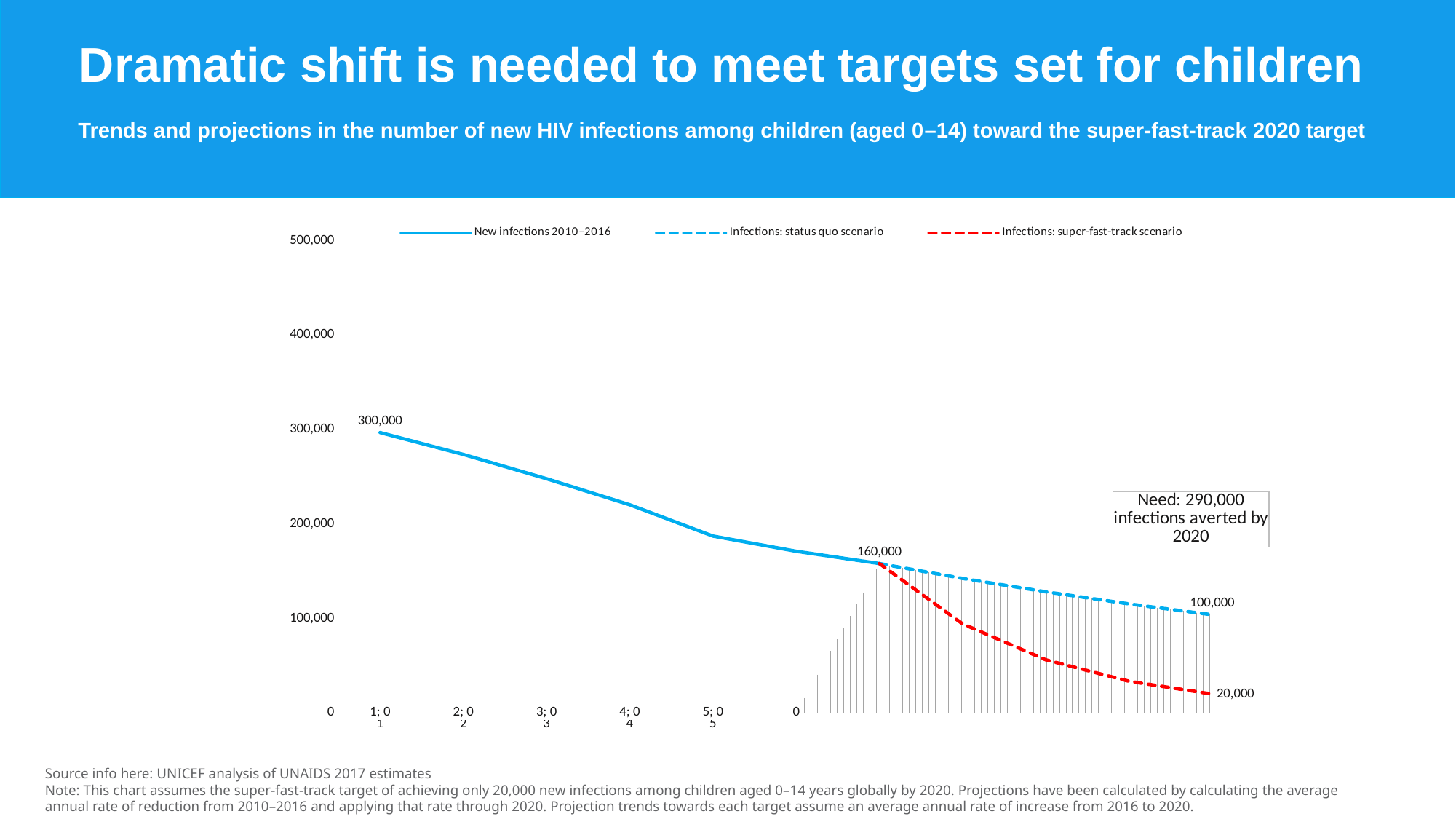
By how much does the 'New infections 2010–2016' line fall from its starting value of 300,000 to its ending value of 160,000? 140,000 What is the final value of the 'Infections: status quo scenario' line? 100,000 What is the final value of the 'Infections: super-fast-track scenario' line? 20,000 Does the 'New infections 2010–2016' line rise or fall from left to right? fall What is the value at the point where the solid 'New infections 2010–2016' line ends and the projection lines begin? 160,000 What is the difference between the final value of the status quo scenario (100,000) and the final value of the super-fast-track scenario (20,000)? 80,000 What is the value at the start of the 'New infections 2010–2016' line? 300,000 What kind of chart is shown on the slide? line chart How many series does the legend list? 3 According to the annotation box on the chart, how many infections need to be averted by 2020? 290,000 Which scenario ends at a higher value, the status quo scenario or the super-fast-track scenario? status quo scenario What colour is the dashed line for the 'Infections: super-fast-track scenario' series? red